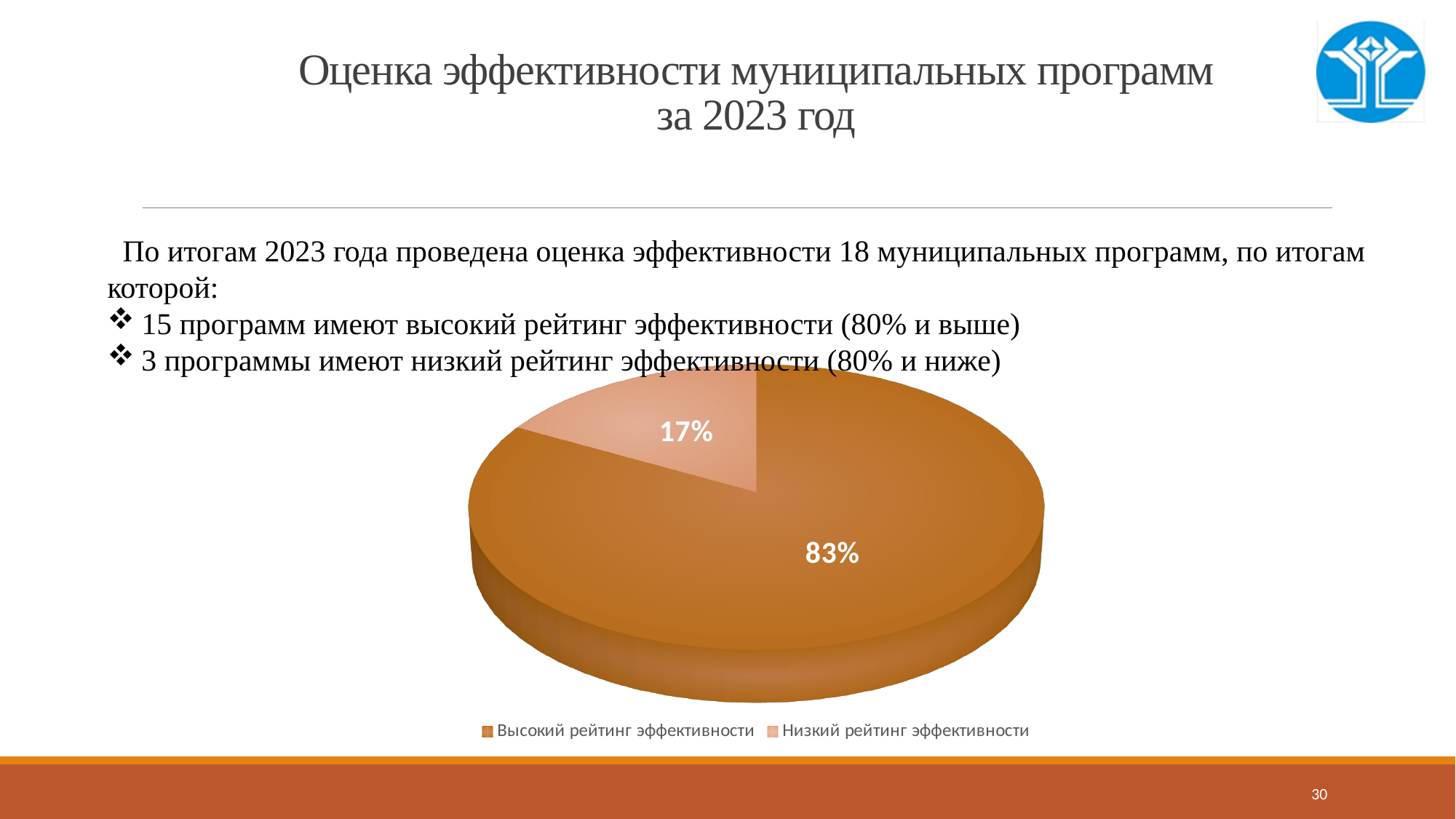
Which slice of the pie is the largest? Высокий рейтинг эффективности What share of the pie does 'Низкий рейтинг эффективности' take? 17% What share of the pie does 'Высокий рейтинг эффективности' take? 83% What is the difference in percentage points between the 'Высокий рейтинг эффективности' slice and the 'Низкий рейтинг эффективности' slice? 66 Which legend entry is shown in the lighter (pale orange) colour? Низкий рейтинг эффективности What kind of chart is shown on the slide? pie chart How many entries does the legend list? 2 Which slice of the pie is the smallest? Низкий рейтинг эффективности Which is larger: the 'Высокий рейтинг эффективности' slice or the 'Низкий рейтинг эффективности' slice? Высокий рейтинг эффективности How many slices does the pie chart have? 2 Is the share for 'Низкий рейтинг эффективности' greater or less than 50%? less